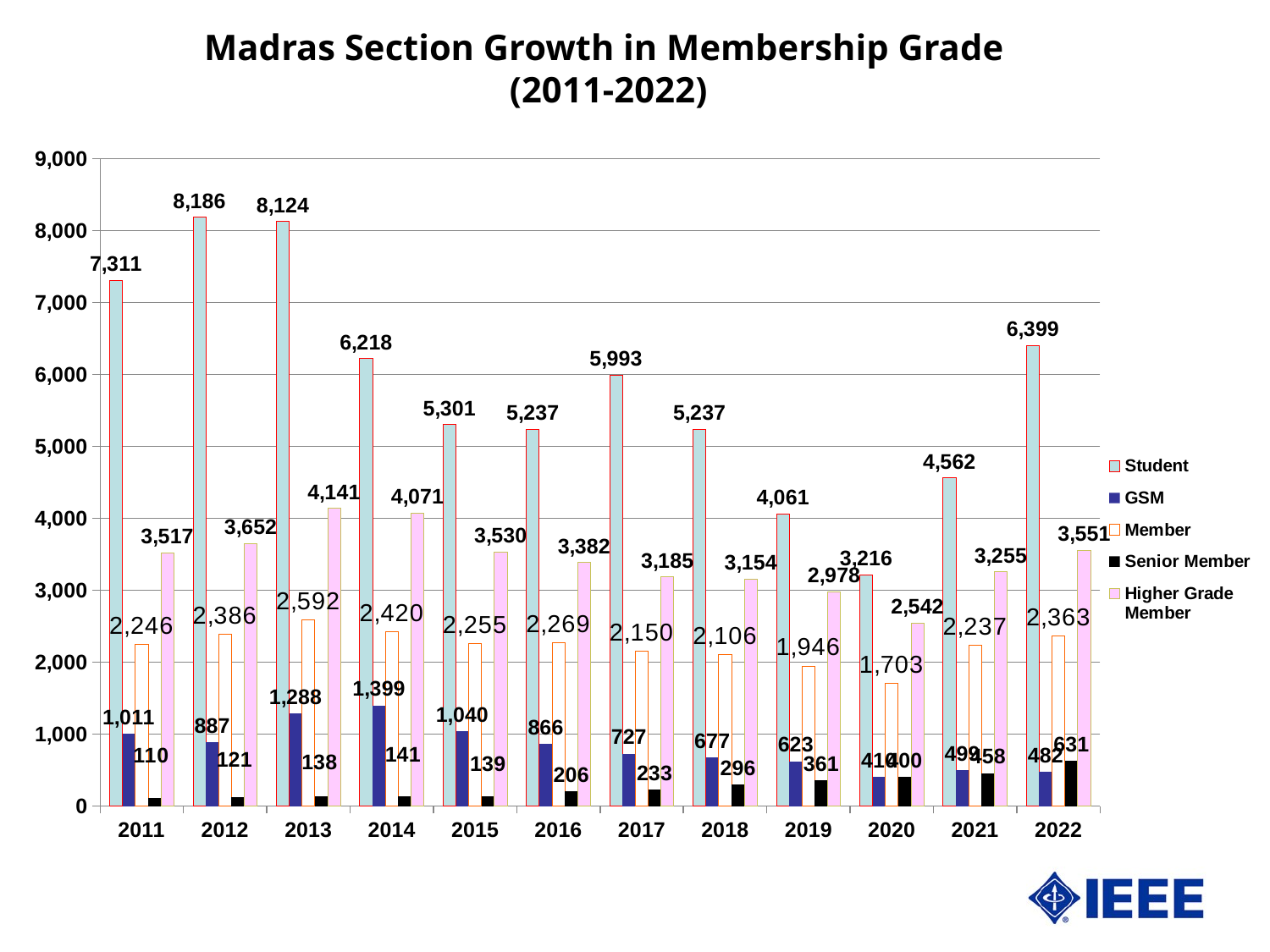
In which year is the Student value highest? 2012 What kind of chart is shown on the slide? Bar chart What is the Member value for 2019? 1,946 How many series does the legend list? 5 Which is larger, the GSM value for 2014 or the GSM value for 2013? 2014 In which year is the Student value lowest? 2020 What is the Student value for 2012? 8,186 How many years are shown on the x axis? 12 What is the title of the chart? Madras Section Growth in Membership Grade (2011-2022) What is the difference between the Student values for 2022 and 2021? 1,837 What is the Higher Grade Member value for 2013? 4,141 What is the Senior Member value for 2022? 631